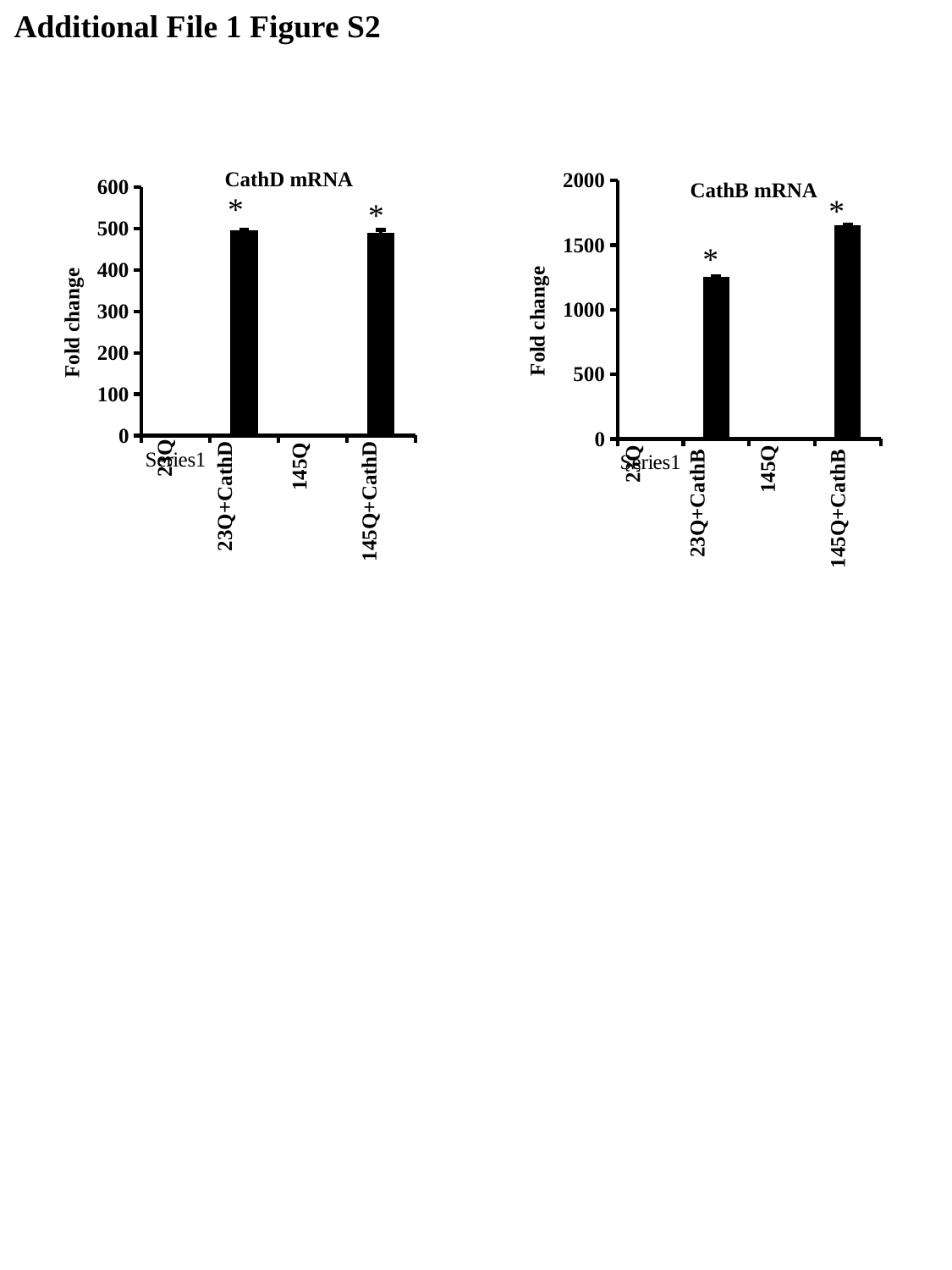
In the CathD mRNA chart, is the value for 23Q+CathD greater or less than 400? greater In the CathB mRNA chart, is the value for 23Q+CathB greater or less than 1500? less How many categories are shown on the x axis of the CathB mRNA chart? 4 How many categories are shown on the x axis of the CathD mRNA chart? 4 What is the title of the chart on the right side of the slide? CathB mRNA What is the y-axis label of the CathD mRNA chart? Fold change In the CathB mRNA chart, which category has the highest value? 145Q+CathB In the CathD mRNA chart, is the value for 145Q+CathD greater or less than 600? less In the CathB mRNA chart, which is larger, the value for 23Q+CathB or the value for 145Q+CathB? 145Q+CathB What kind of chart is the CathD mRNA chart? bar chart